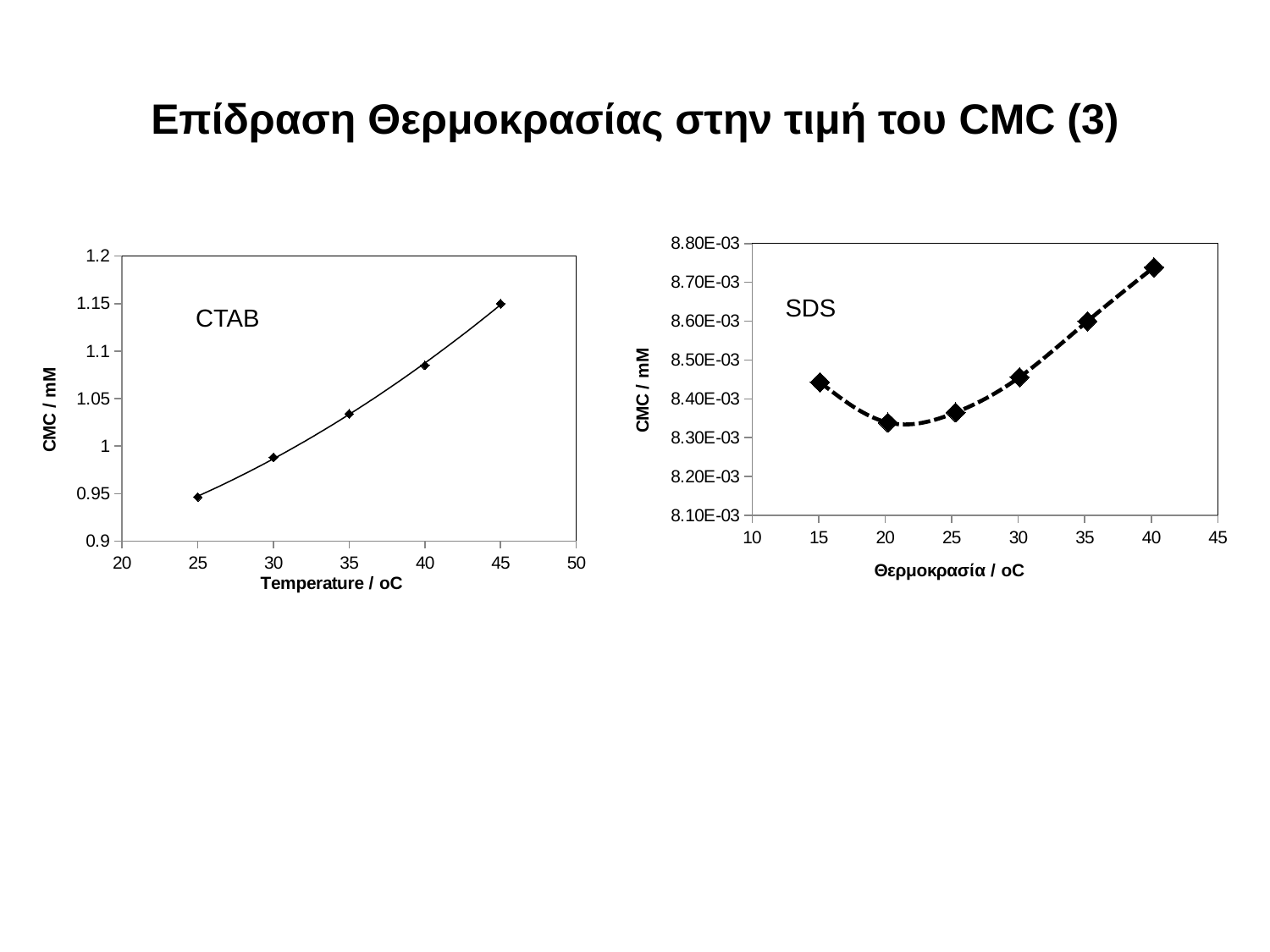
On the CTAB chart, at which temperature is the CMC highest? 45 On the CTAB chart, is the CMC value at 40 °C greater or less than 1.05? greater What kind of chart is the CTAB chart on the left? line chart On the SDS chart, is the CMC value at 40 °C greater or less than 8.70E-03? greater How many data points are plotted on the CTAB chart? 5 On the SDS chart, which has the larger CMC value: 15 °C or 25 °C? 15 °C What is the x-axis title of the CTAB chart? Temperature / oC On the CTAB chart, does the CMC rise or fall as temperature increases? rise How many data points are plotted on the SDS chart? 6